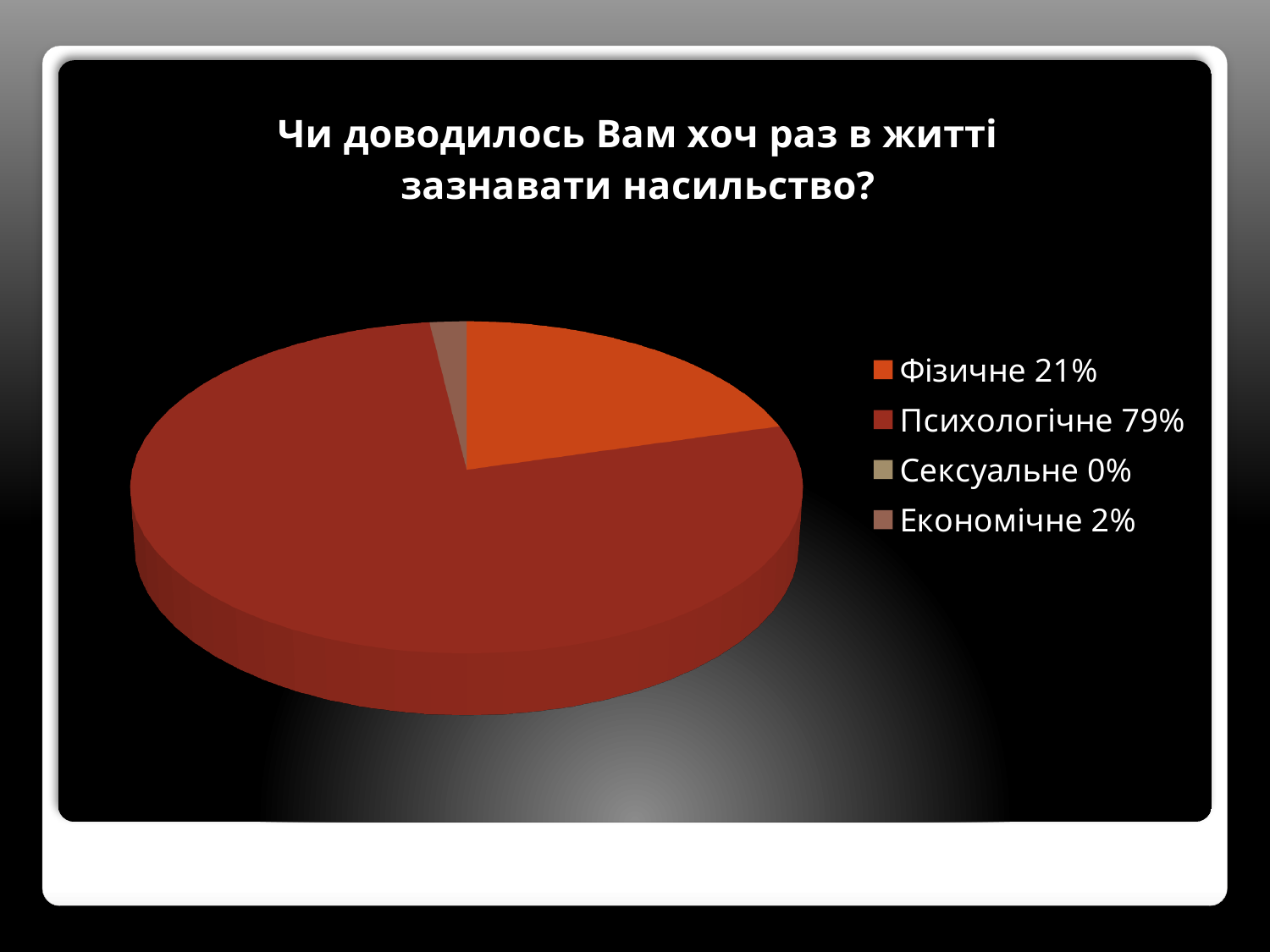
What kind of chart is shown on the slide? Pie chart What percentage is shown for Економічне? 2% What percentage is shown for Психологічне? 79% Which is larger, Фізичне or Економічне? Фізичне How many categories does the legend list? 4 What is the difference in percentage points between Психологічне and Фізичне? 58 What is the title of the chart? Чи доводилось Вам хоч раз в житті зазнавати насильство? What percentage is shown for Фізичне? 21% What colour is the slice for Фізичне? Orange Which category has the smallest share of the pie? Сексуальне Which category has the largest share of the pie? Психологічне What percentage is shown for Сексуальне? 0%